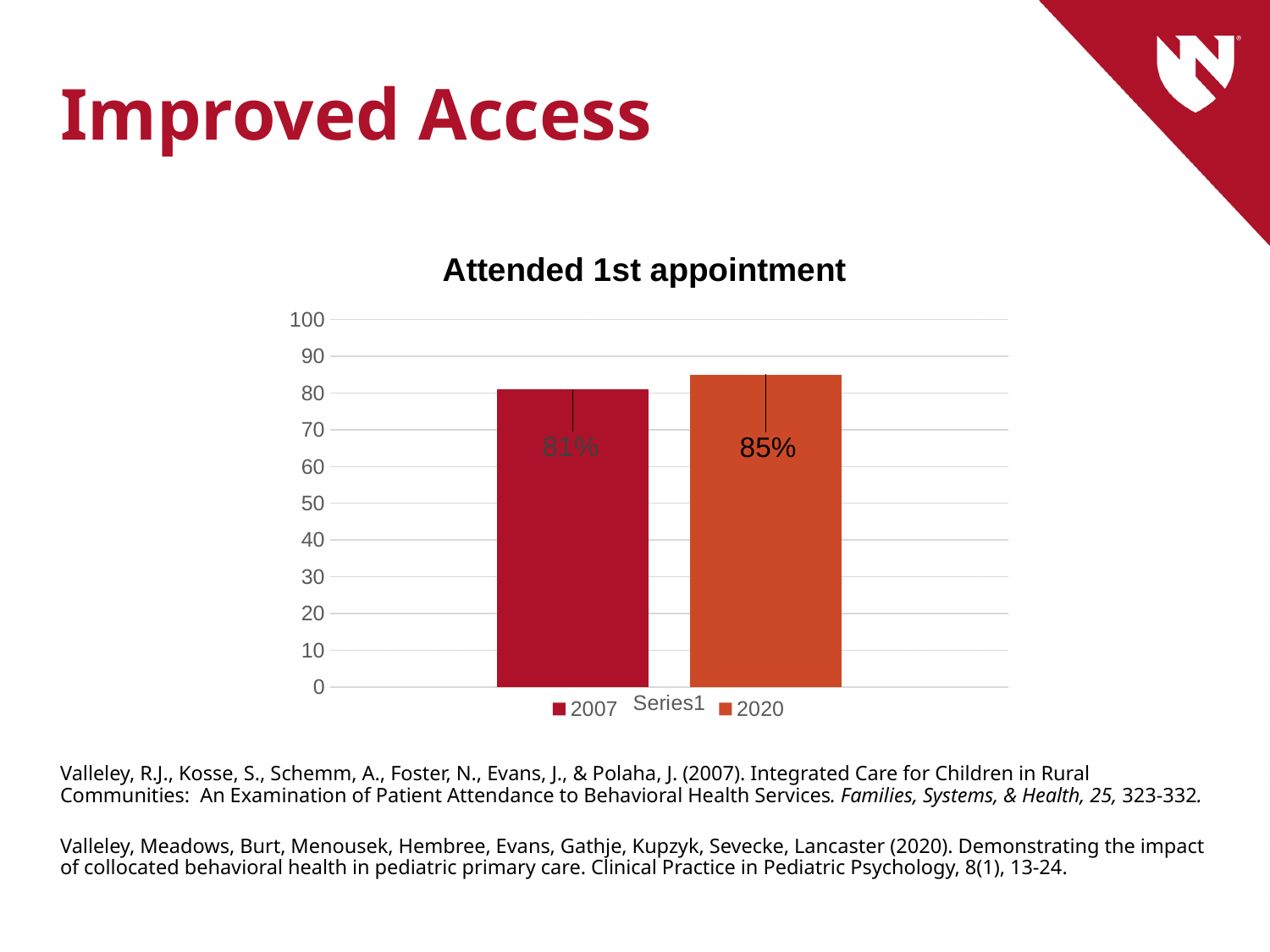
What kind of chart is shown on the slide? bar chart What is the title of the chart? Attended 1st appointment What is the value for 2007 in the Attended 1st appointment chart? 81% What is the value for 2020 in the Attended 1st appointment chart? 85% Which series has the higher value, 2007 or 2020? 2020 Which series has the highest value in the chart? 2020 Is the value for 2020 greater or less than 80? greater What is the maximum value shown on the vertical axis of the chart? 100 How many series does the legend list? 2 Which series has the lowest value in the chart? 2007 What is the difference between the 2020 value and the 2007 value? 4% Is the value for 2007 greater or less than 90? less